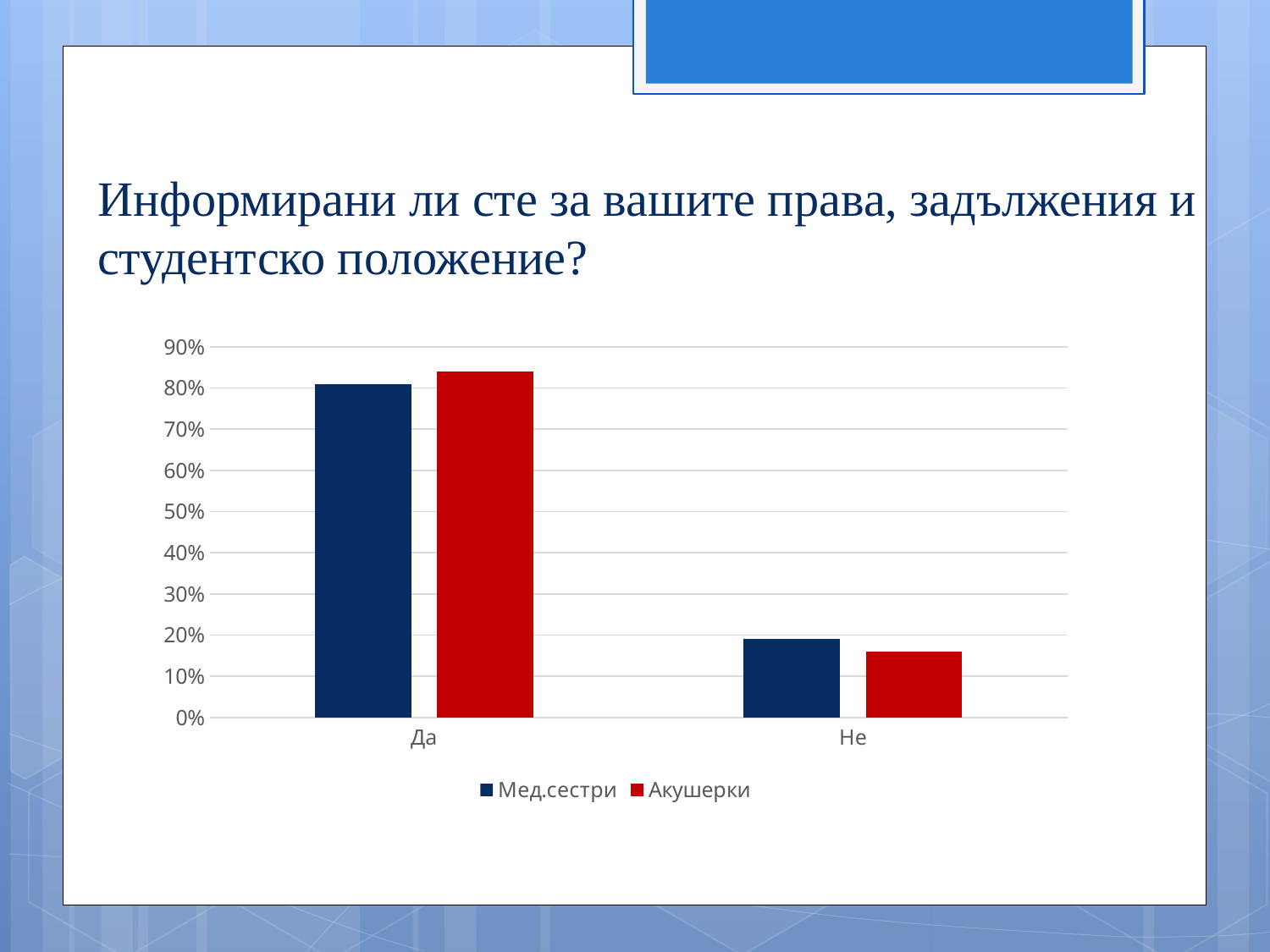
Is the value for Мед.сестри in the Да category greater or less than 70%? greater Is the value for Акушерки in the Не category greater or less than 10%? greater Is the value for Акушерки in the Да category greater or less than 80%? greater Which series is shown in red in the legend? Акушерки In the Не category, which series has the higher value, Мед.сестри or Акушерки? Мед.сестри How many series does the legend list? 2 How many categories are shown on the x axis? 2 In the Да category, which series has the higher value, Мед.сестри or Акушерки? Акушерки What are the two categories on the x axis? Да and Не What type of chart is shown on the slide? bar chart